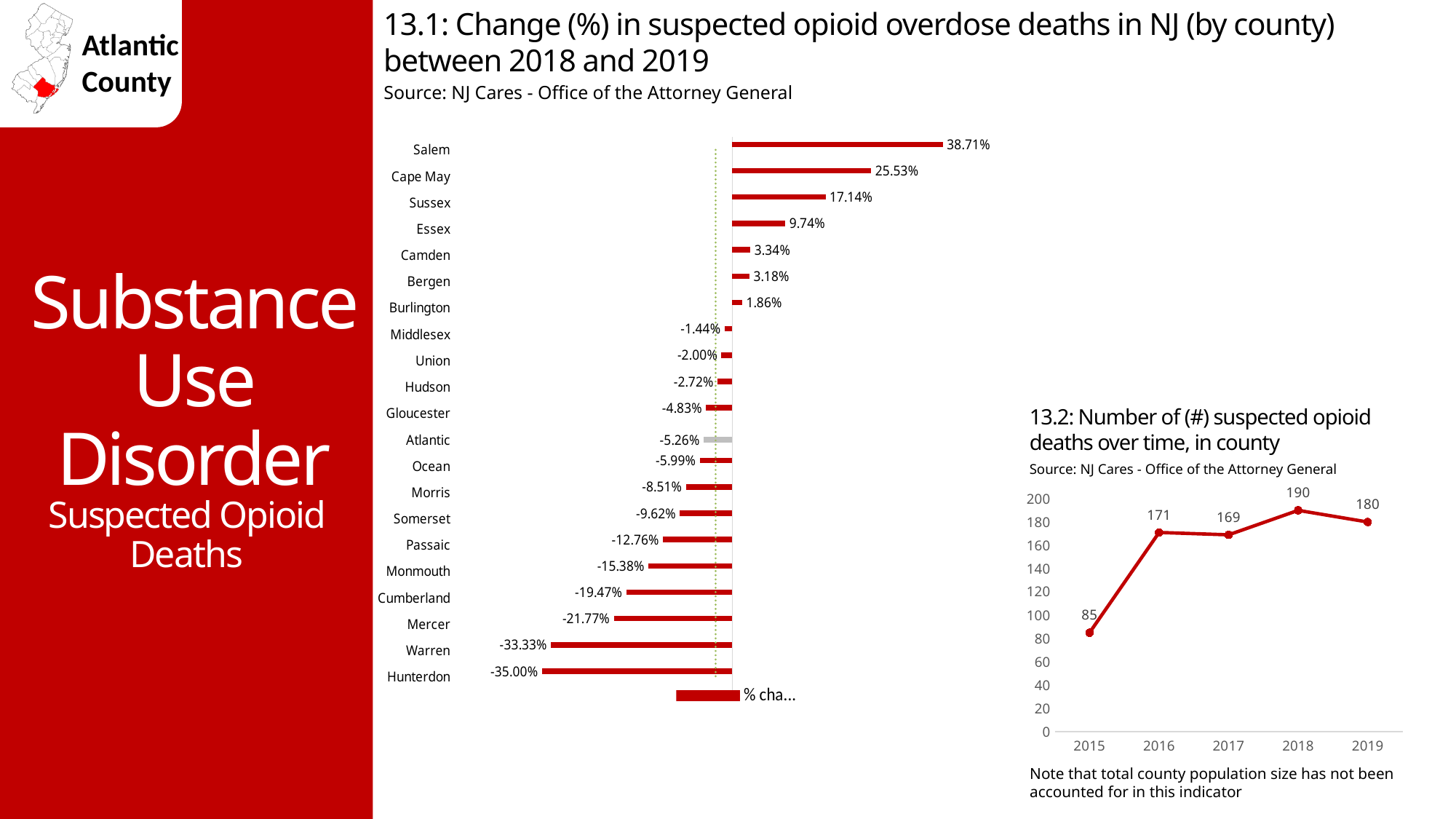
In chart 13.2, what is the difference between the values for 2018 and 2019? 10 In chart 13.1, what is the percentage change for Atlantic County? -5.26% What kind of chart is chart 13.2? Line chart In chart 13.1, what is the difference between the values for Salem and Cape May? 13.18 percentage points In chart 13.2, what is the number of suspected opioid deaths in 2018? 190 In chart 13.1, which has a larger percentage change, Sussex or Essex? Sussex In chart 13.1, which county has the highest percentage change? Salem What kind of chart is chart 13.1? Bar chart In chart 13.2, which year has the lowest number of suspected opioid deaths? 2015 In chart 13.1, which county has the lowest percentage change? Hunterdon In chart 13.1, what is the percentage change for Cape May? 25.53% In chart 13.1, how many counties are shown? 21